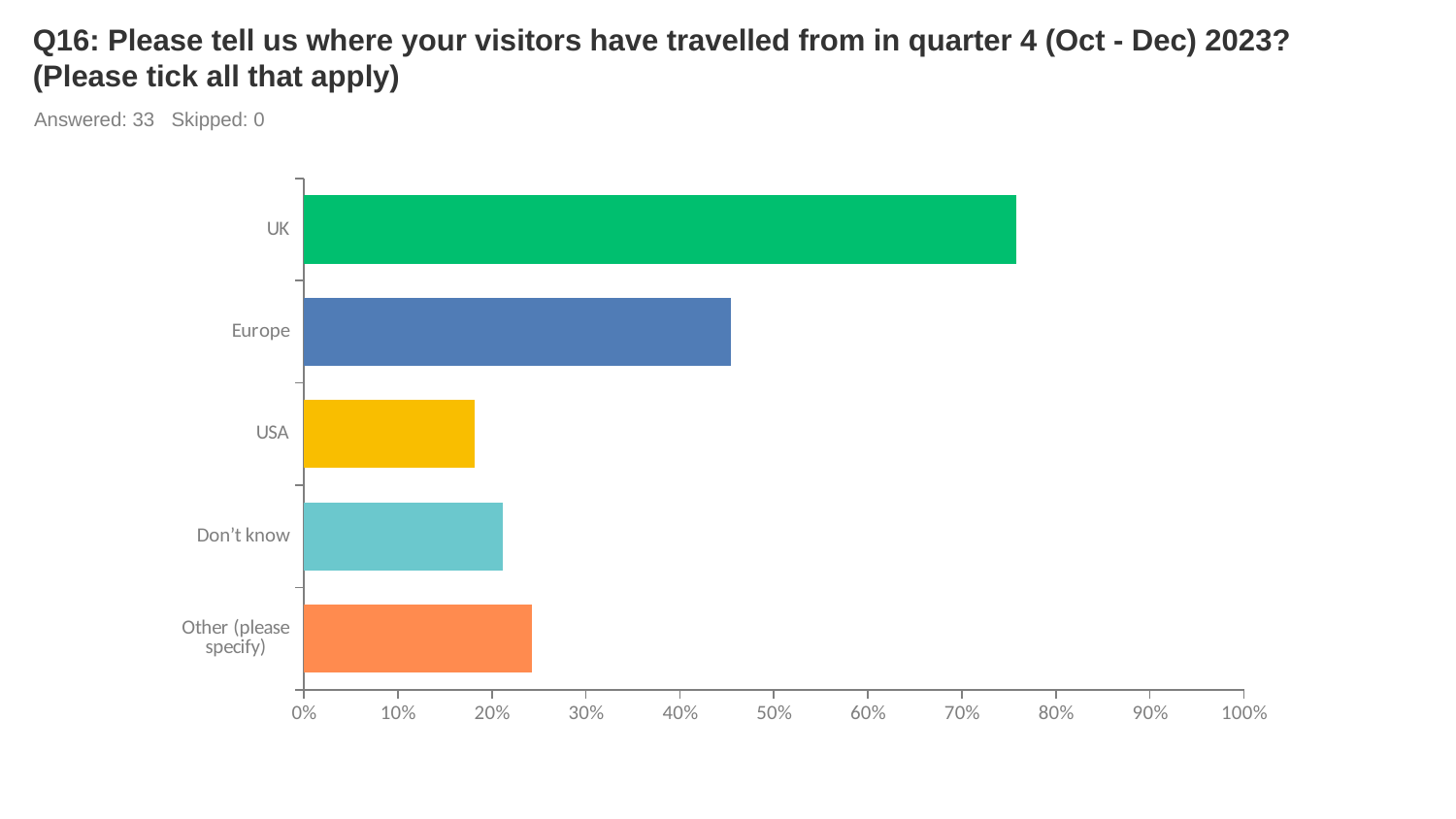
Is the value for Other (please specify) greater or less than 30%? less Is the value for USA greater or less than 20%? less Which category has the lowest value? USA Is the value for UK greater or less than 70%? greater Which category has the highest value? UK How many categories are shown in the chart? 5 What kind of chart is shown on the slide? bar chart How many respondents answered this question according to the slide? 33 Which is larger, the value for USA or the value for Don't know? Don't know Which is larger, the value for Europe or the value for Other (please specify)? Europe